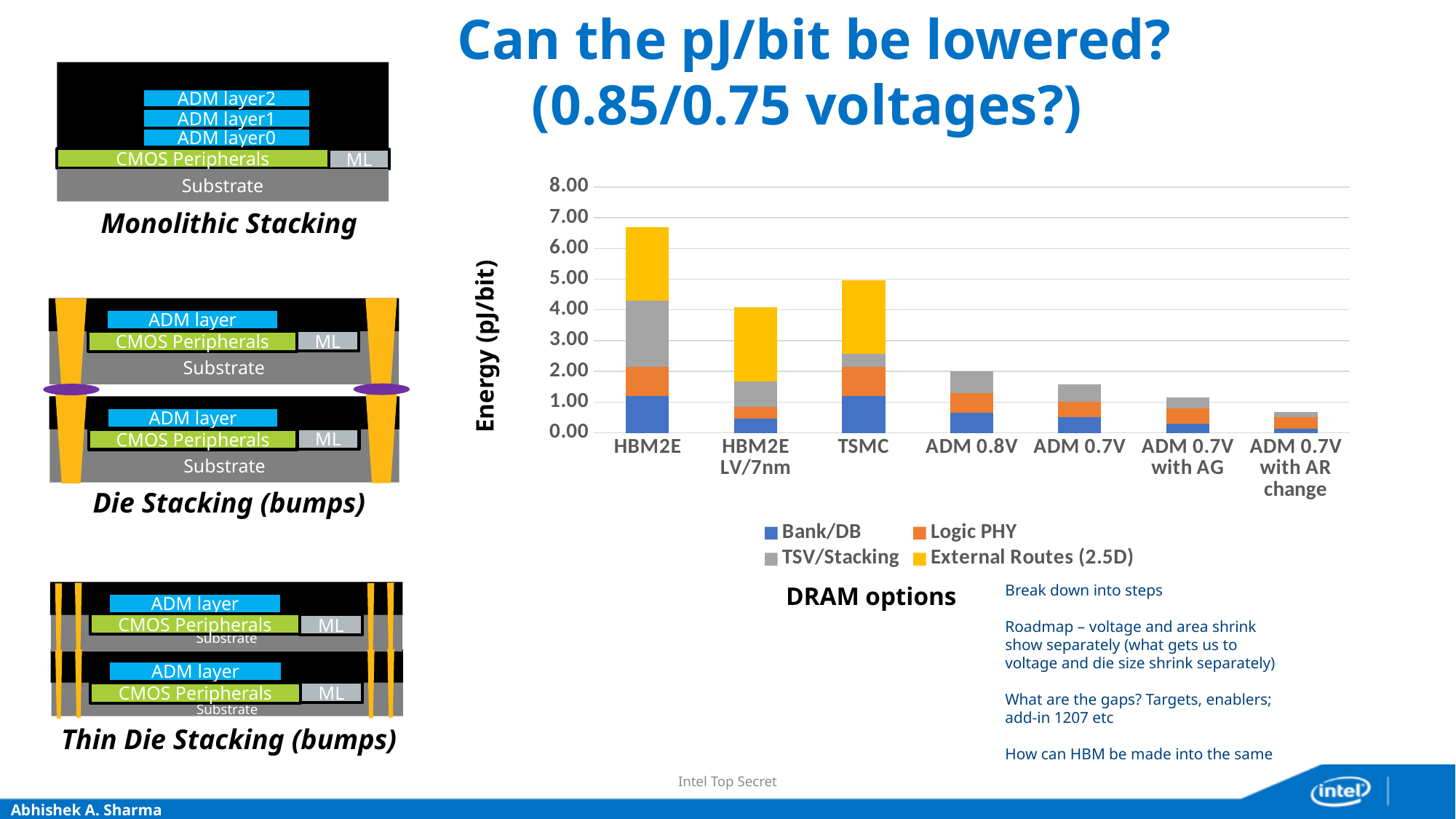
Is the total energy for ADM 0.8V greater or less than 3.00 pJ/bit? less How many DRAM options (categories) are plotted on the x axis of the chart? 7 What is the label of the chart's y axis? Energy (pJ/bit) Which DRAM option has the lowest total energy in the chart? ADM 0.7V with AR change Which series in the chart is shown in yellow? External Routes (2.5D) Which DRAM option has the highest total energy in the chart? HBM2E Is the total energy for HBM2E LV/7nm greater or less than 5.00 pJ/bit? less Is the total energy for HBM2E greater or less than 6.00 pJ/bit? greater How many series does the chart's legend list? 4 What kind of chart is shown on the slide? Stacked bar chart Which has the larger total energy, TSMC or HBM2E LV/7nm? TSMC